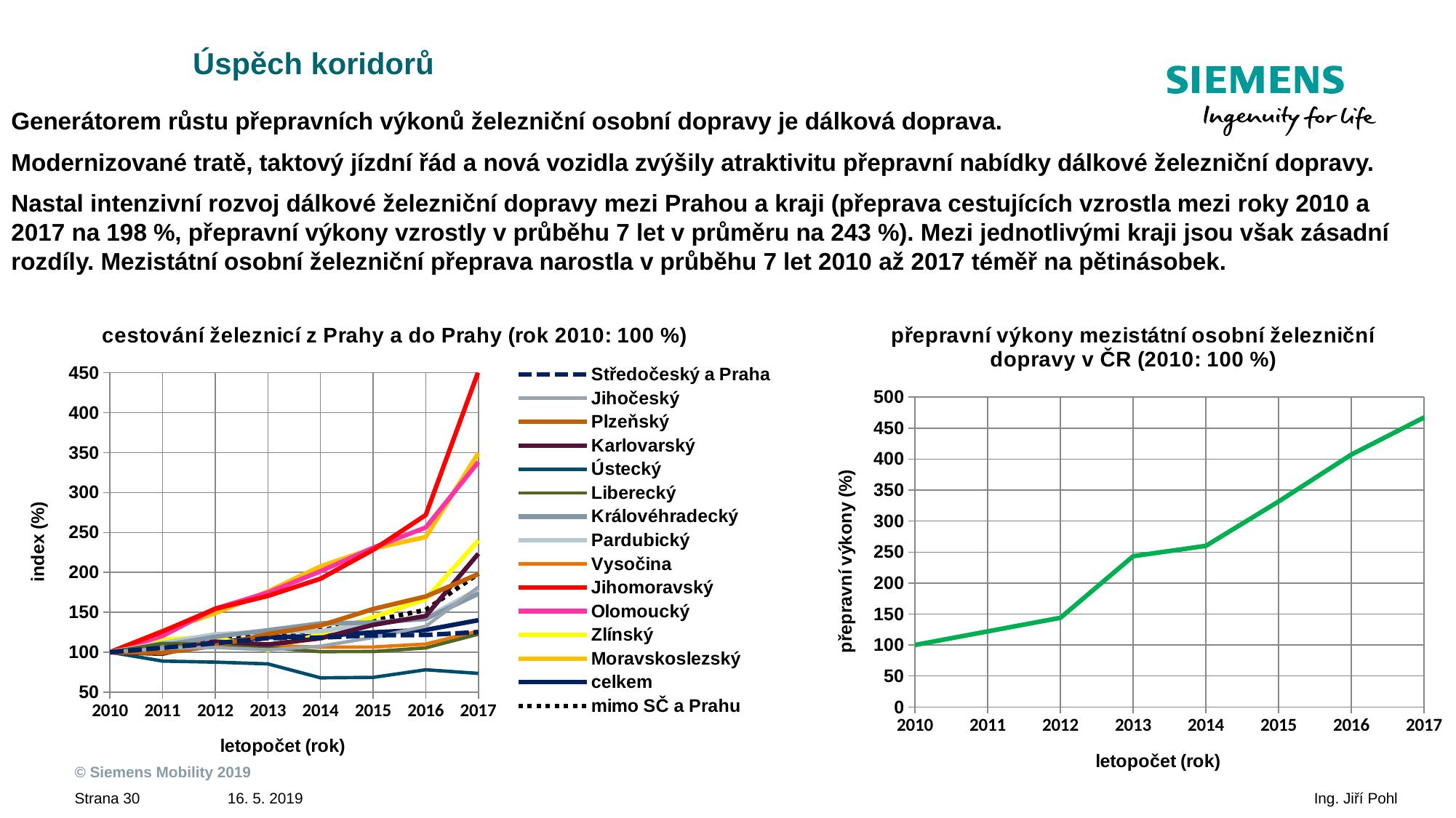
In the left chart ("cestování železnicí z Prahy a do Prahy"), which is larger in 2017: Olomoucký or Karlovarský? Olomoucký How many years are shown on the x axis of the right chart ("přepravní výkony mezistátní osobní železniční dopravy v ČR")? 8 What kind of chart is the chart titled "cestování železnicí z Prahy a do Prahy (rok 2010: 100 %)"? line chart What is the y-axis label of the right chart ("přepravní výkony mezistátní osobní železniční dopravy v ČR")? přepravní výkony (%) In the right chart ("přepravní výkony mezistátní osobní železniční dopravy v ČR"), do the values rise or fall from 2010 to 2017? rise In the left chart ("cestování železnicí z Prahy a do Prahy"), which series has the highest value in 2017? Jihomoravský How many series does the legend of the left chart ("cestování železnicí z Prahy a do Prahy") list? 15 In the left chart ("cestování železnicí z Prahy a do Prahy"), is the value for Jihomoravský in 2017 greater or less than 400? greater In the right chart ("přepravní výkony mezistátní osobní železniční dopravy v ČR"), is the value for 2017 greater or less than 400? greater In the right chart ("přepravní výkony mezistátní osobní železniční dopravy v ČR"), what is the value for 2010? 100 In the left chart ("cestování železnicí z Prahy a do Prahy"), is the value for Ústecký in 2017 greater or less than 100? less In the left chart ("cestování železnicí z Prahy a do Prahy"), which series has the lowest value in 2017? Ústecký